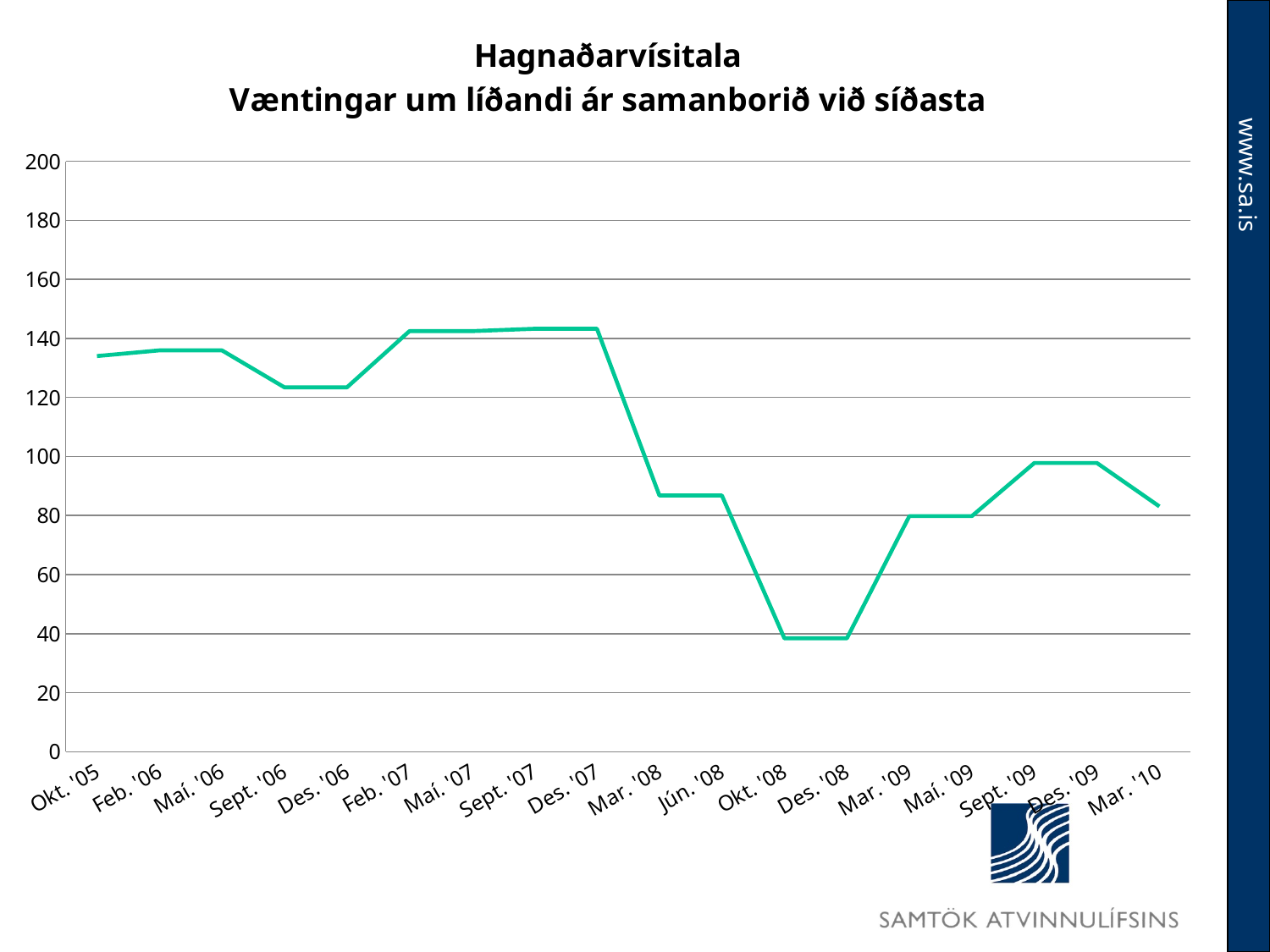
What is the title of the chart? Hagnaðarvísitala Væntingar um líðandi ár samanborið við síðasta Which is larger, the value for Sept. '09 or the value for Mar. '10? Sept. '09 Is the value for Mar. '08 greater or less than 80? greater What kind of chart is shown on the slide? line chart How many data points are plotted along the x axis? 18 Does the line rise or fall between Des. '07 and Okt. '08? fall Is the value for Okt. '08 greater or less than 60? less Is the value for Sept. '06 greater or less than 100? greater Does the line rise or fall between Des. '08 and Sept. '09? rise Which is larger, the value for Okt. '05 or the value for Okt. '08? Okt. '05